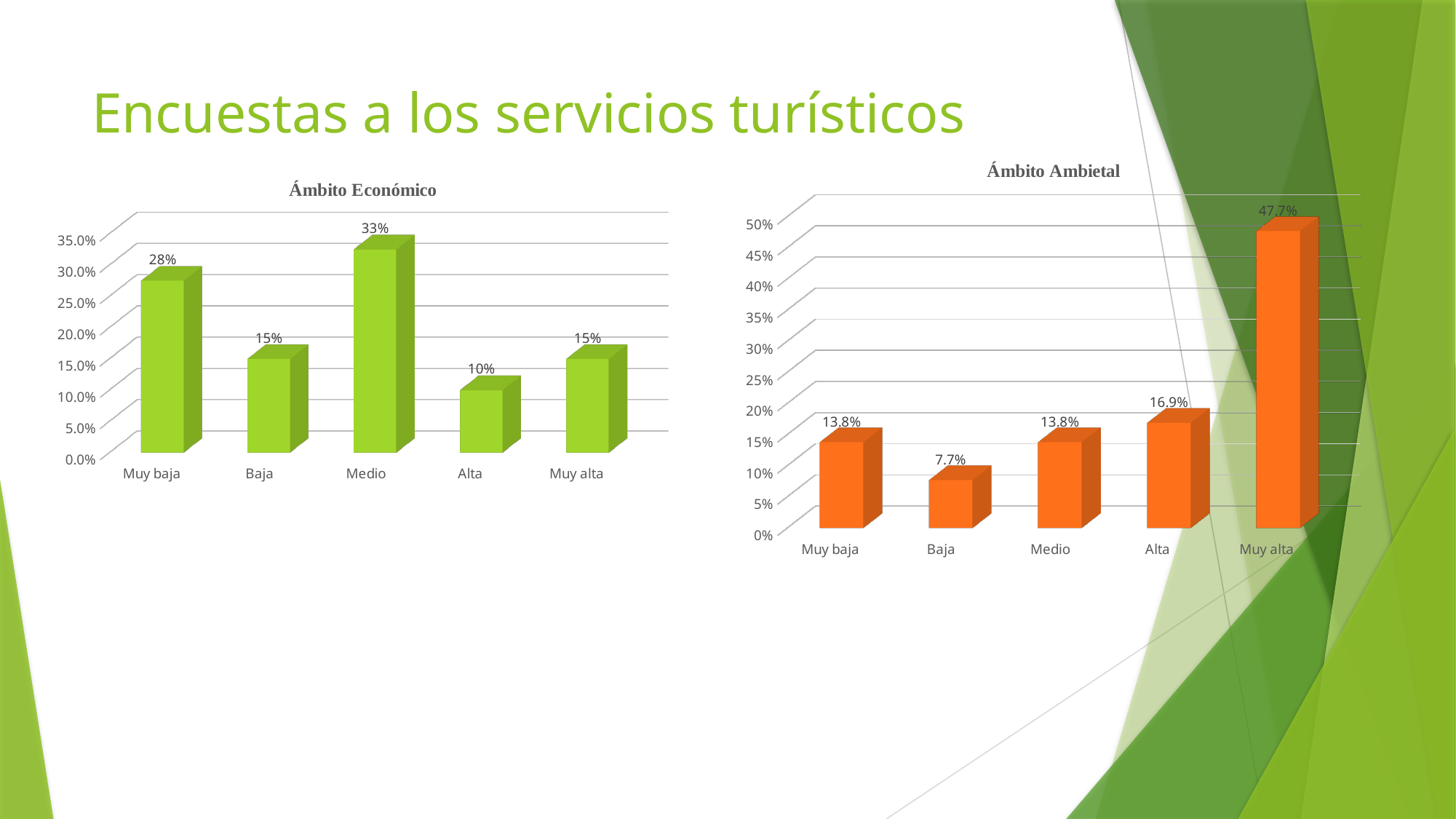
In the 'Ámbito Ambietal' chart, what is the value for Baja? 7.7% In the 'Ámbito Económico' chart, what is the value for Muy baja? 28% In the 'Ámbito Económico' chart, what is the difference between the values for Medio and Alta? 23% In the 'Ámbito Ambietal' chart, what is the value for Muy alta? 47.7% In the 'Ámbito Económico' chart, how many categories are shown on the x axis? 5 In the 'Ámbito Ambietal' chart, which is larger, the value for Alta or the value for Medio? Alta In the 'Ámbito Económico' chart, what is the value for Medio? 33% In the 'Ámbito Ambietal' chart, which category has the lowest value? Baja In the 'Ámbito Ambietal' chart, what is the difference between the values for Muy alta and Alta? 30.8% What kind of chart is the 'Ámbito Ambietal' chart? Bar chart In the 'Ámbito Económico' chart, which category has the highest value? Medio In the 'Ámbito Económico' chart, which category has the lowest value? Alta